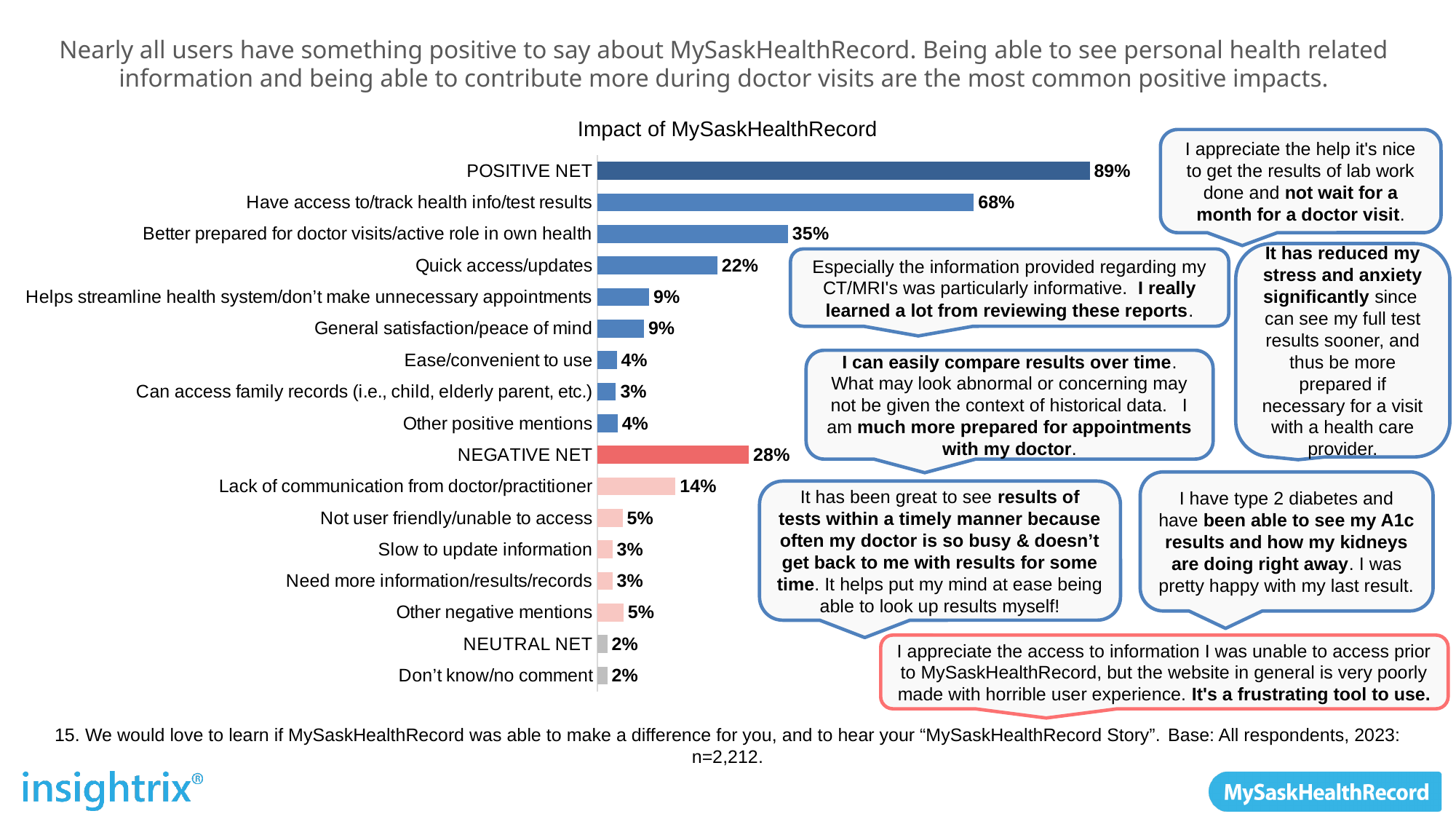
What is the value for NEGATIVE NET? 28% What percentage of respondents mentioned 'Have access to/track health info/test results'? 68% Which is larger: 'Not user friendly/unable to access' or 'Slow to update information'? Not user friendly/unable to access What is the difference between POSITIVE NET and NEGATIVE NET? 61% What type of chart is used to show the Impact of MySaskHealthRecord? Bar chart What is the value for 'Quick access/updates'? 22% How many categories are shown in the Impact of MySaskHealthRecord chart? 17 What is the value for POSITIVE NET in the Impact of MySaskHealthRecord chart? 89% What is the difference between 'Have access to/track health info/test results' and 'Better prepared for doctor visits/active role in own health'? 33% Which category has the highest value in the chart? POSITIVE NET What is the title of the chart? Impact of MySaskHealthRecord What is the value for 'Lack of communication from doctor/practitioner'? 14%